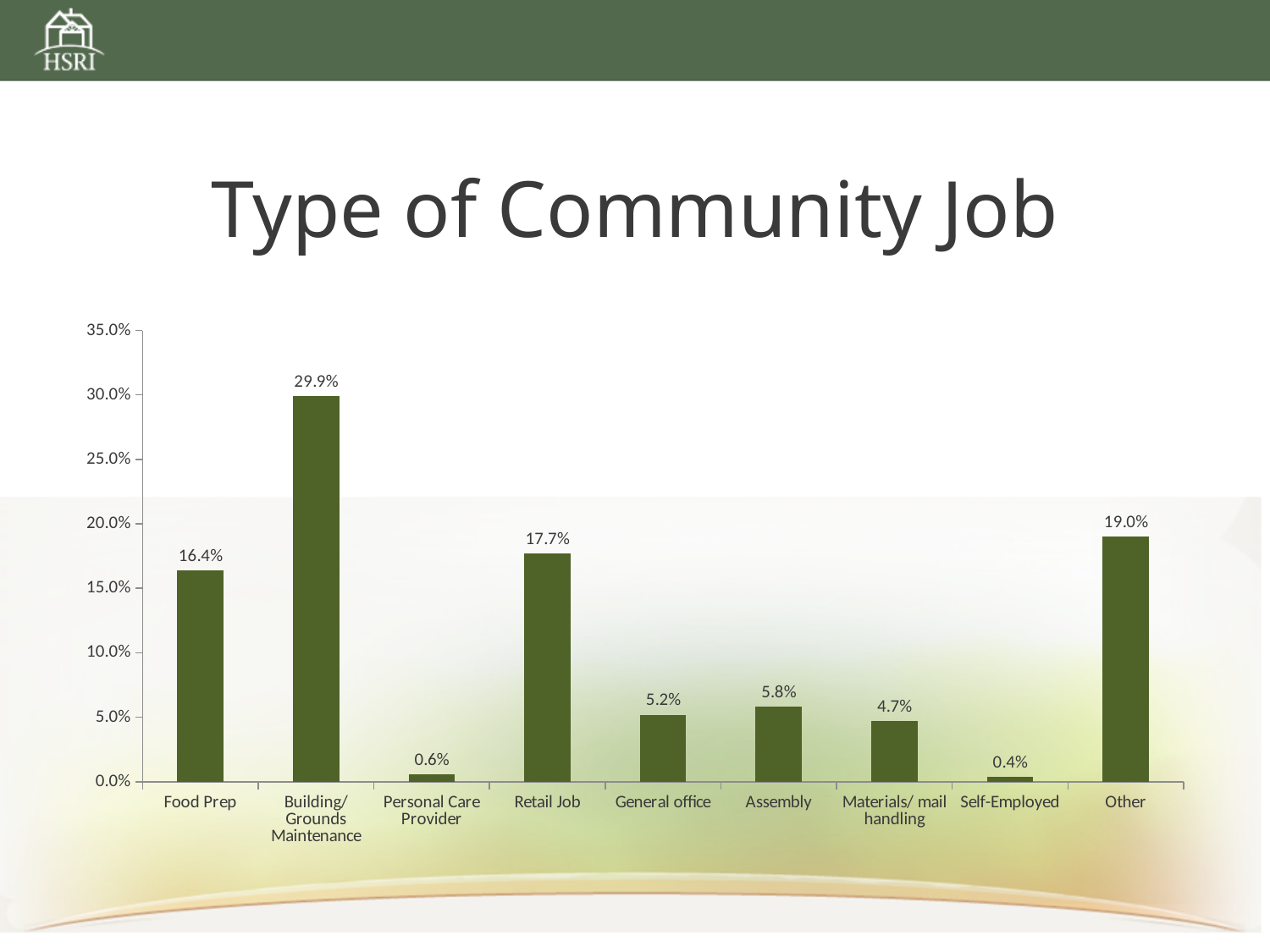
What is the difference between the values for Other and Food Prep? 2.6% Which is larger, the value for Assembly or the value for General office? Assembly Which category has the highest value? Building/Grounds Maintenance What kind of chart is shown on the slide? bar chart Which category has the lowest value? Self-Employed What is the value for Materials/ mail handling? 4.7% What is the value for Self-Employed? 0.4% What is the title of the chart? Type of Community Job Is the value for Food Prep greater or less than 15.0%? greater What is the value for Retail Job? 17.7% How many categories are shown on the x axis? 9 What is the value for Building/Grounds Maintenance? 29.9%